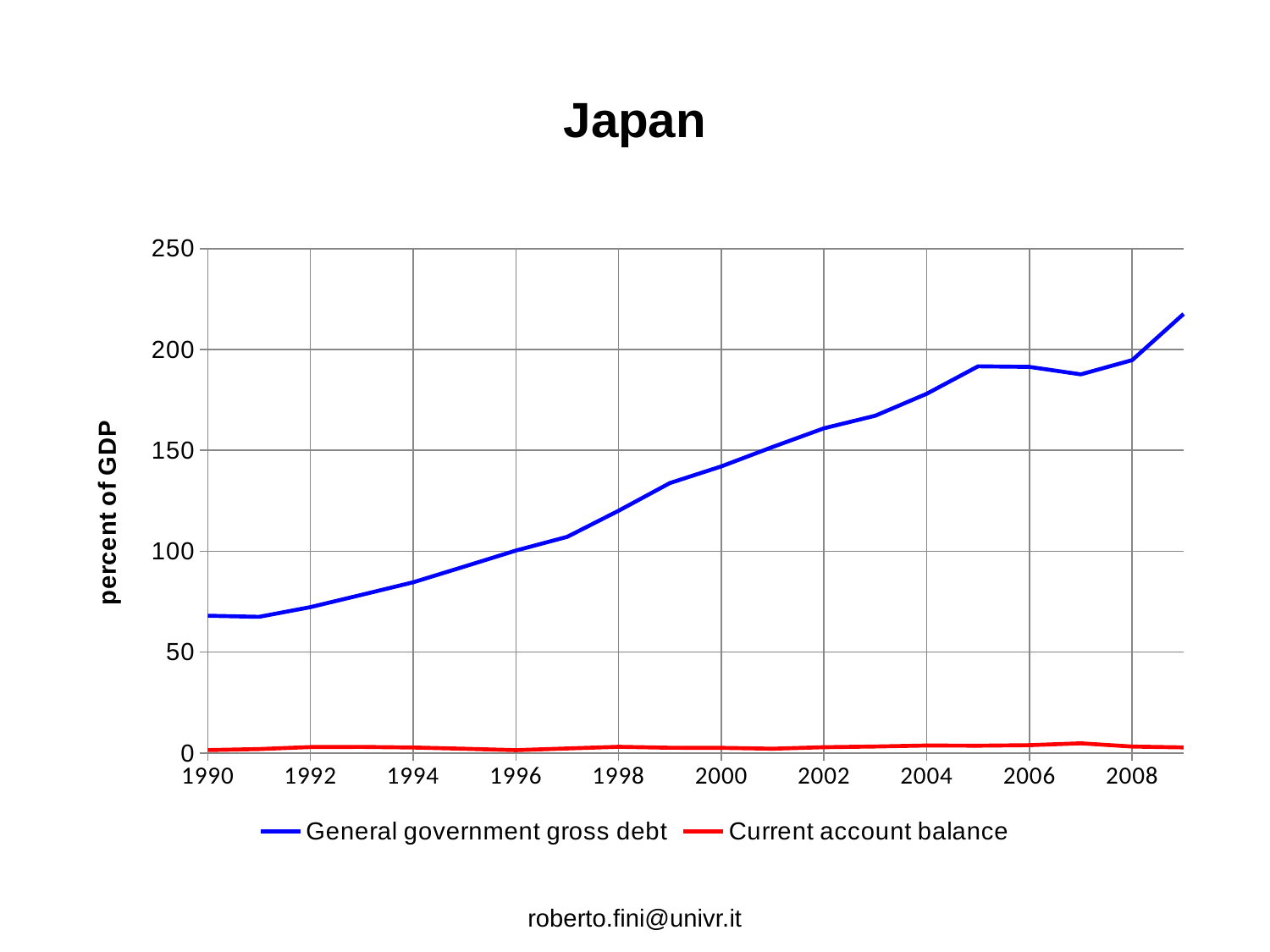
Is the value for General government gross debt in 1990 greater or less than 100? less In which year is General government gross debt at its highest? 2009 Does the General government gross debt series generally rise or fall from 1990 to 2009? rise Is the value for General government gross debt in 2005 greater or less than 150? greater Is the value for General government gross debt in 2009 greater or less than 200? greater How many year labels are shown on the x axis? 10 How many series does the legend list? 2 Which series has the larger value in 2004, General government gross debt or Current account balance? General government gross debt What is the title of the chart? Japan What kind of chart is shown on the slide? line chart What is the label on the vertical axis? percent of GDP